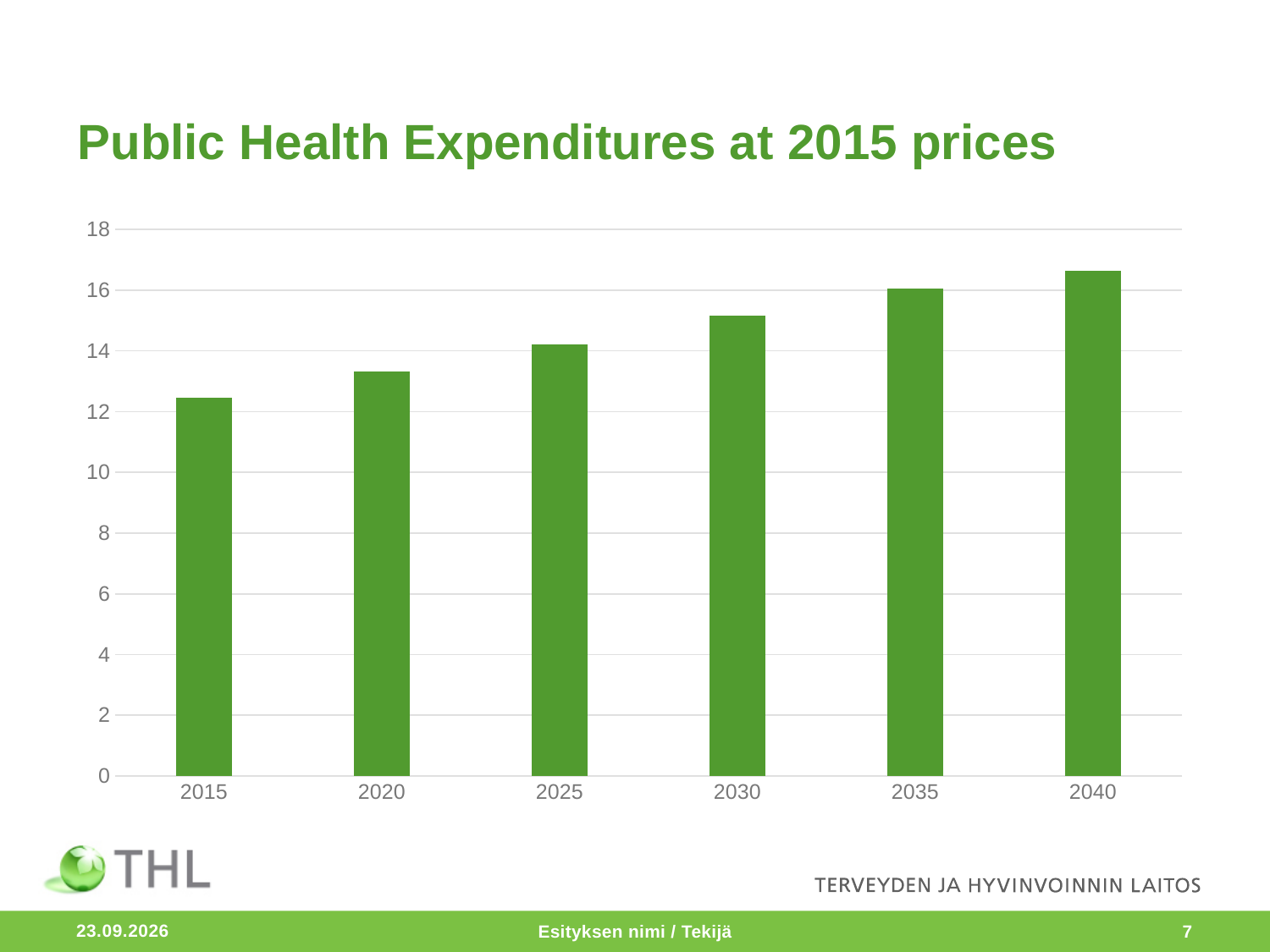
Is the value for 2040 greater or less than 16? greater Which year has the highest public health expenditure? 2040 What colour are the bars in the chart? green Is the value for 2015 greater or less than 14? less Which year has the lowest public health expenditure? 2015 What kind of chart is shown on the slide? bar chart What is the title of the chart? Public Health Expenditures at 2015 prices Do the values rise or fall from 2015 to 2040? rise Is the value for 2030 greater or less than 14? greater Which is larger, the value for 2030 or the value for 2020? 2030 How many years (bars) are shown in the chart? 6